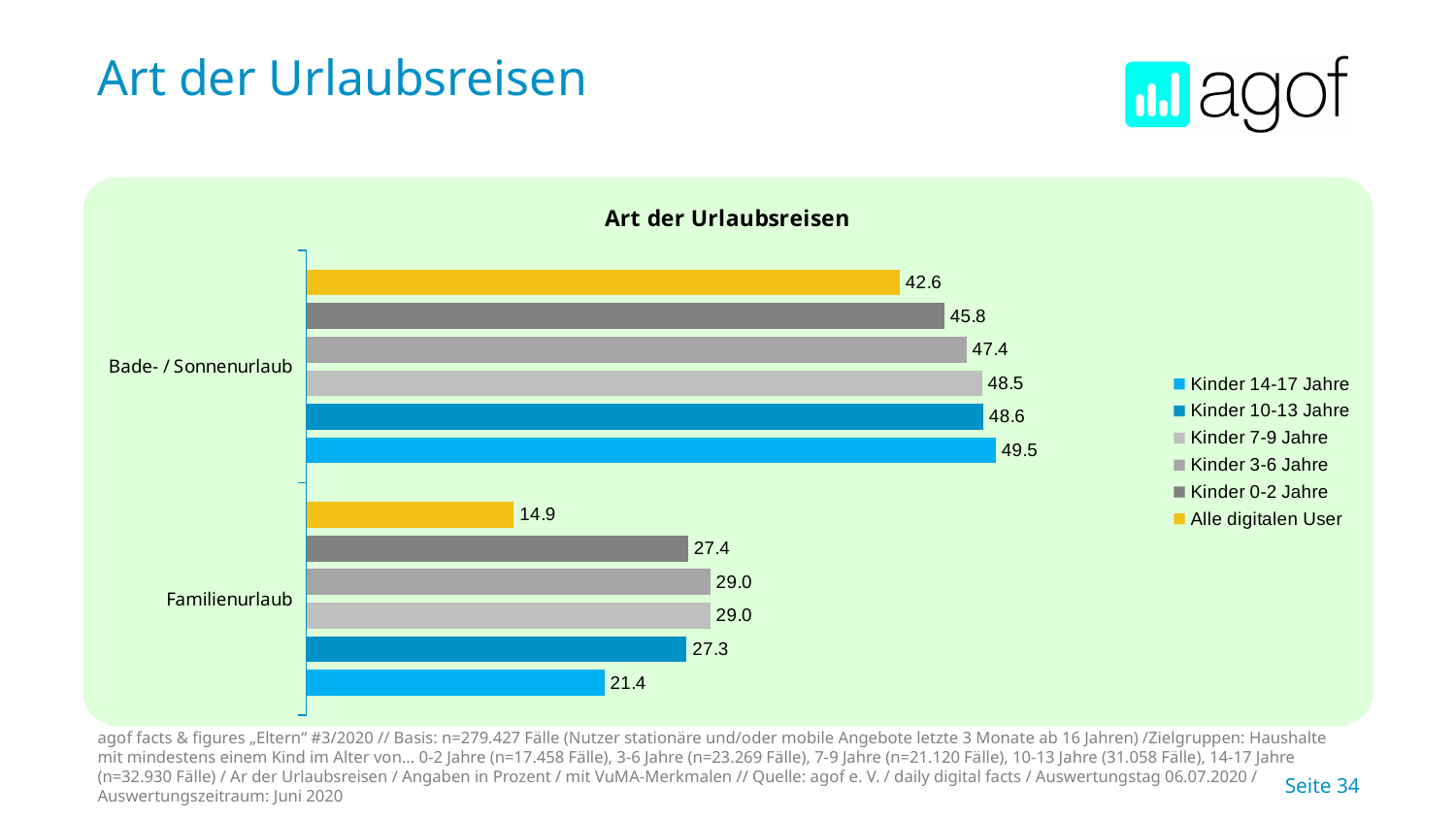
What is the value for Kinder 14-17 Jahre for Familienurlaub? 21.4 What is the value for Kinder 10-13 Jahre for Bade- / Sonnenurlaub? 48.6 How many series does the legend list? 6 Which series has the highest value for Bade- / Sonnenurlaub? Kinder 14-17 Jahre What is the value for Kinder 0-2 Jahre for Familienurlaub? 27.4 How many categories are shown on the y axis of the chart? 2 Which series has the lowest value for Familienurlaub? Alle digitalen User What is the difference between the Kinder 14-17 Jahre value and the Alle digitalen User value for Bade- / Sonnenurlaub? 6.9 What is the difference between the Kinder 3-6 Jahre value and the Kinder 14-17 Jahre value for Familienurlaub? 7.6 What is the value for Alle digitalen User for Bade- / Sonnenurlaub? 42.6 What kind of chart is shown on the slide? Bar chart For Familienurlaub, which is larger: the value for Kinder 0-2 Jahre or the value for Kinder 14-17 Jahre? Kinder 0-2 Jahre